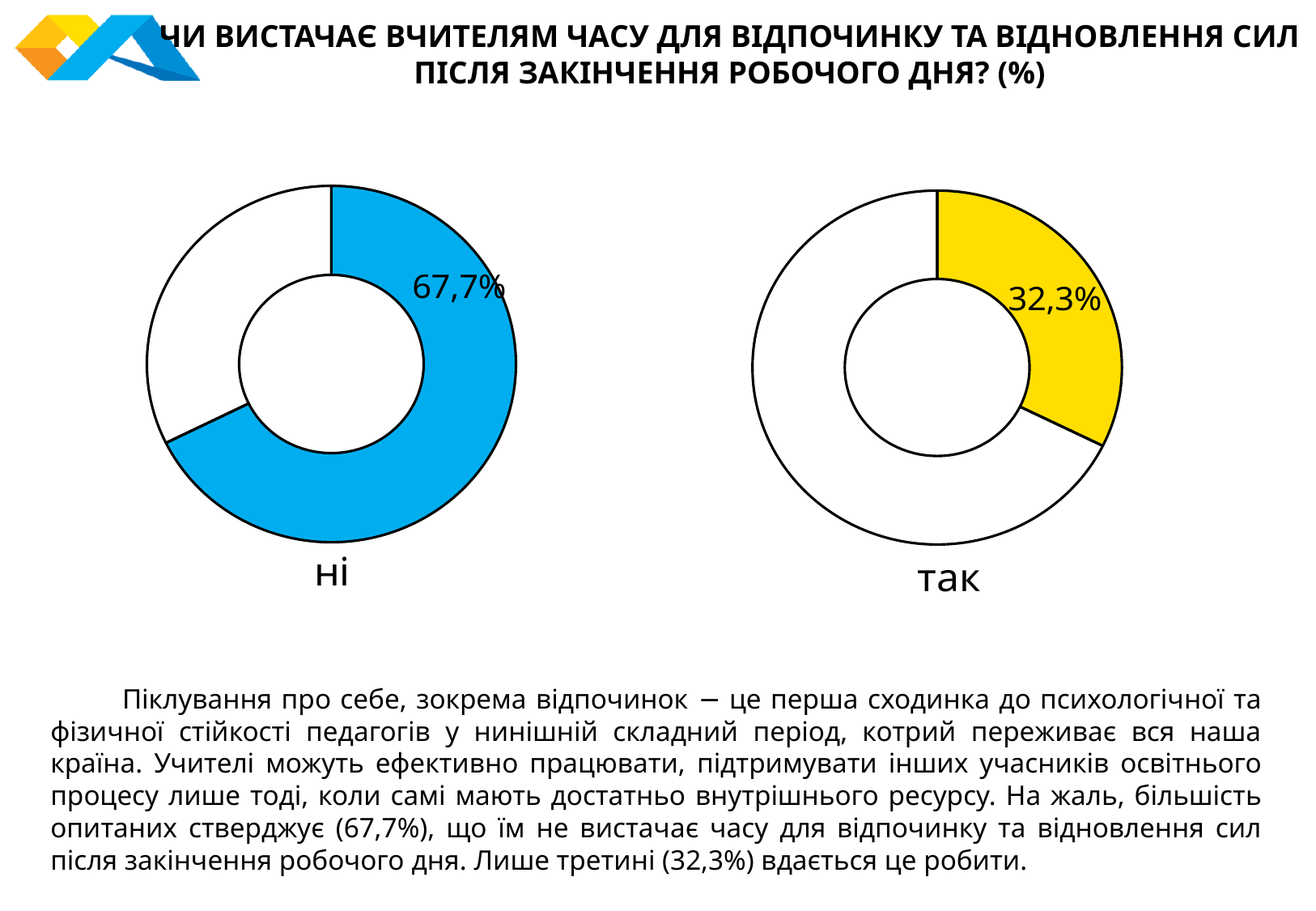
What is the difference between the "ні" share (67,7%) and the "так" share (32,3%)? 35,4% What percentage is shown on the right donut chart labelled "так"? 32,3% How many donut charts are shown on the slide? 2 Which answer has the larger share, "ні" or "так"? ні Which answer option has the smallest share on the slide? так Is the value shown on the "ні" chart greater or less than 50%? greater What colour is the filled segment of the "ні" donut chart? Blue Is the value shown on the "так" chart greater or less than 50%? less What percentage is shown on the left donut chart labelled "ні"? 67,7% What colour is the filled segment of the "так" donut chart? Yellow What kind of chart is used on this slide to show the "ні" and "так" shares? Donut (pie) chart